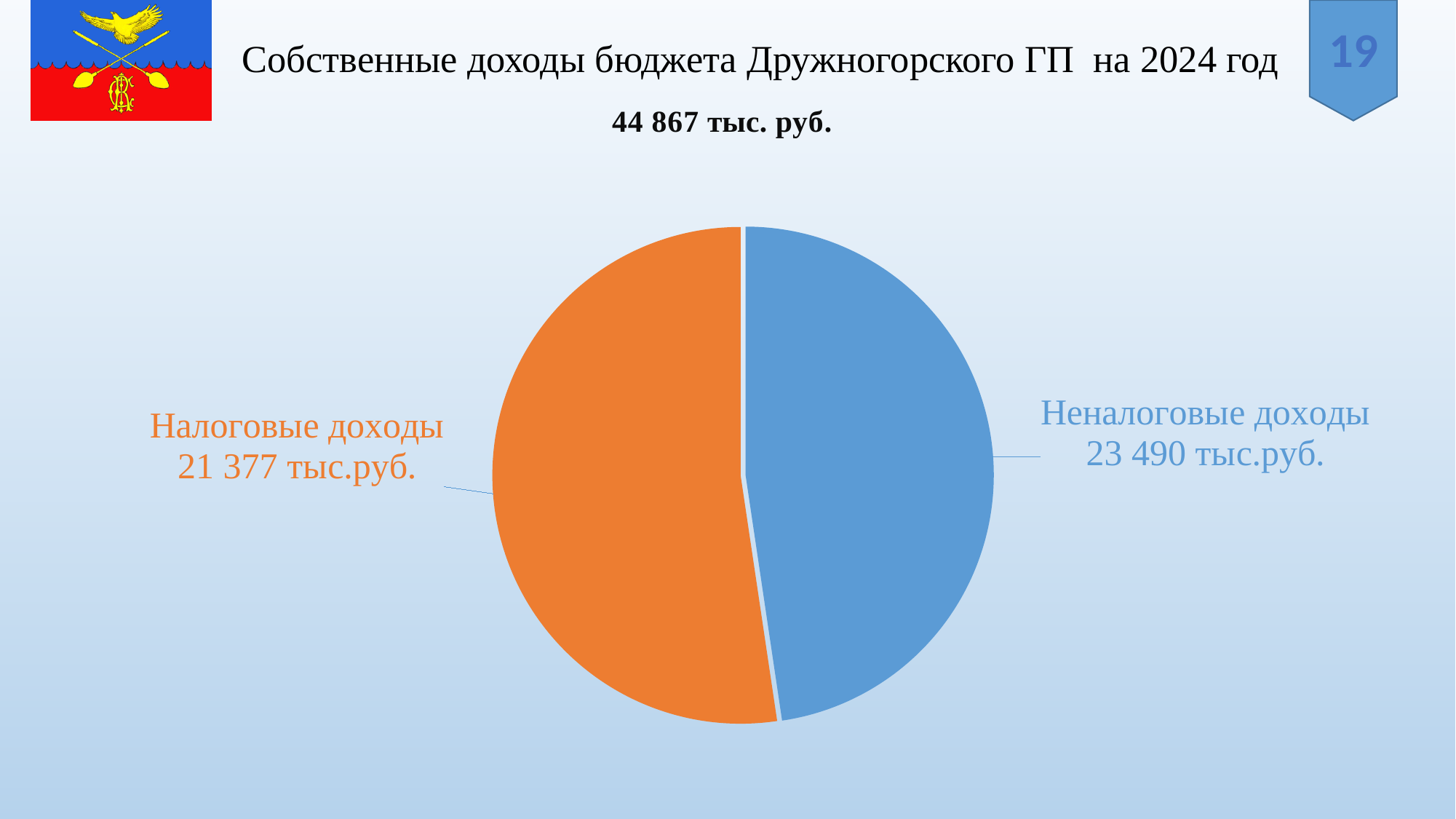
Which category has the largest slice of the pie? Неналоговые доходы What is the difference between Неналоговые доходы and Налоговые доходы? 2 113 тыс.руб. What is the value for Неналоговые доходы? 23 490 тыс.руб. Which is larger, Налоговые доходы or Неналоговые доходы? Неналоговые доходы Which category has the smallest slice of the pie? Налоговые доходы How many slices does the pie chart have? 2 What type of chart is shown on the slide? Pie chart What is the value for Налоговые доходы? 21 377 тыс.руб. What colour is the slice for Налоговые доходы? Orange What is the title of the slide containing the chart? Собственные доходы бюджета Дружногорского ГП на 2024 год What is the total of the two slices shown on the slide? 44 867 тыс. руб.